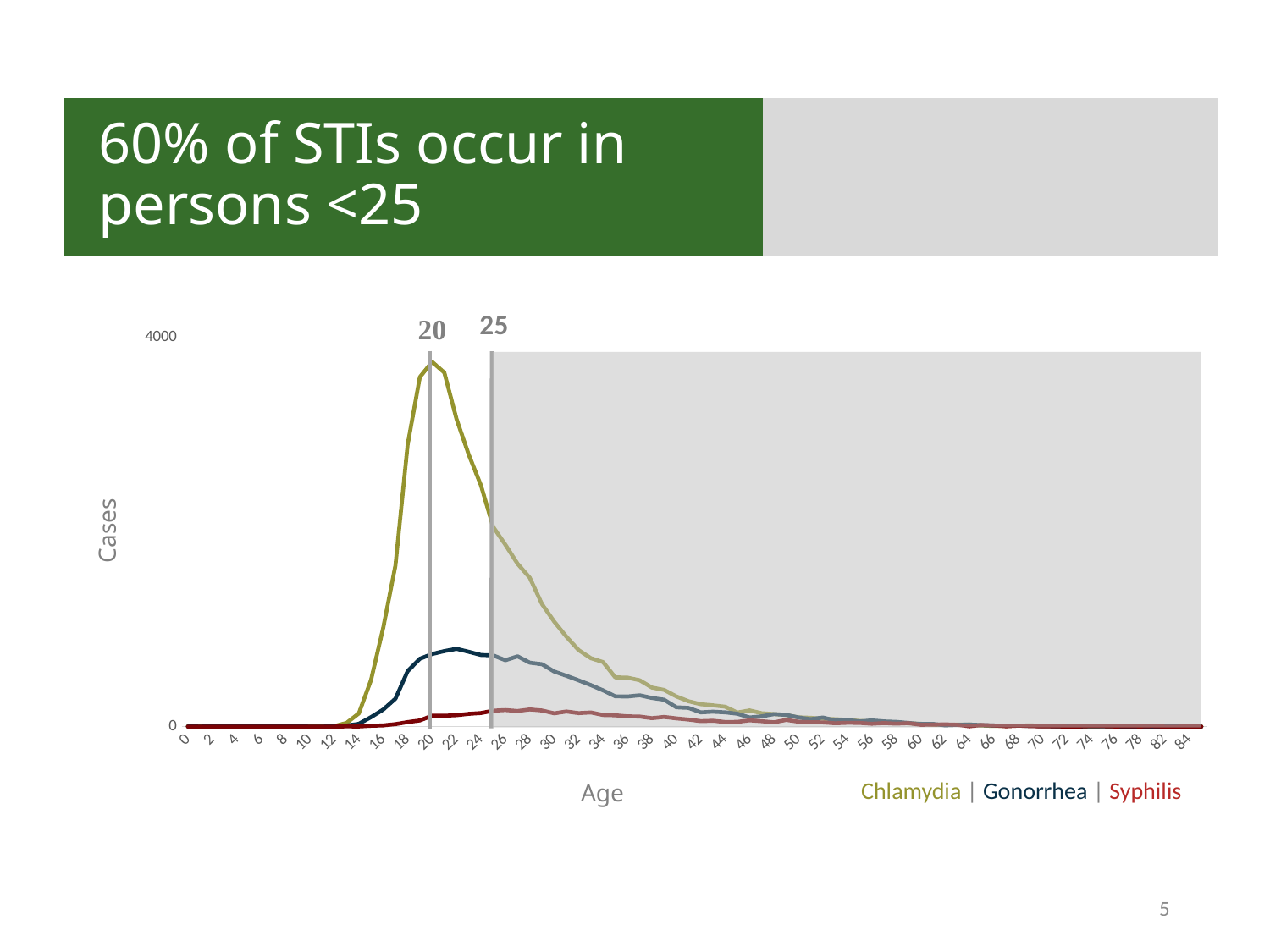
At which age marked by a vertical line does the Chlamydia series peak? 20 Do Chlamydia cases rise or fall between age 25 and age 40? fall What kind of chart is shown on the slide? line chart Which series has the lowest number of cases across all ages? Syphilis What is the label of the y axis? Cases Do Chlamydia cases rise or fall between age 14 and age 20? rise What is the label of the x axis? Age Which series reaches the highest number of cases? Chlamydia How many series does the legend list? 3 At age 20, which series has more cases, Chlamydia or Gonorrhea? Chlamydia Is the value for Gonorrhea at age 20 greater or less than 4000? less At age 22, which series has more cases, Gonorrhea or Syphilis? Gonorrhea